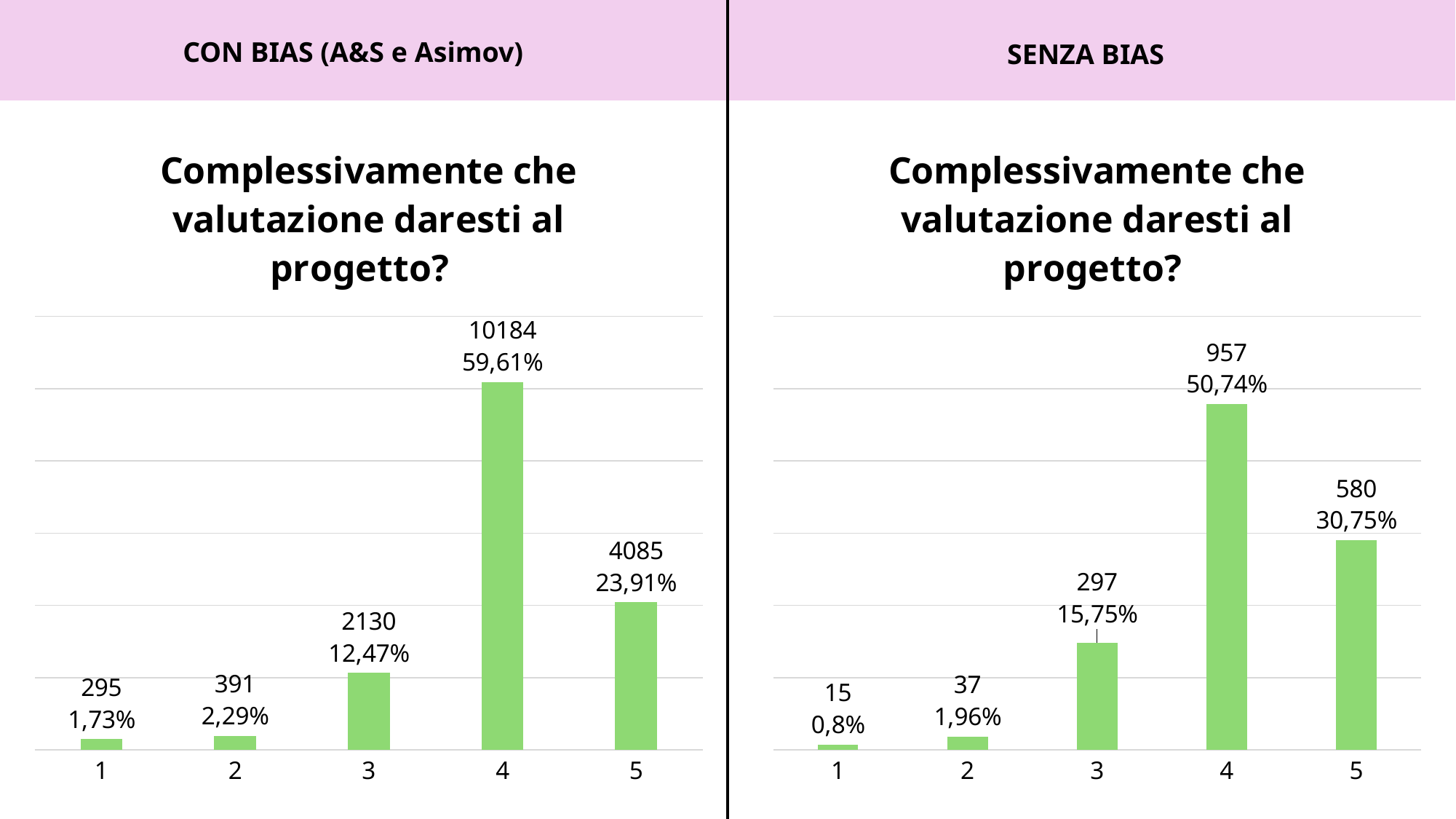
In the left chart (CON BIAS), what is the difference between the counts for rating 4 and rating 5? 6099 What type of chart is used in the SENZA BIAS section? bar chart In the right chart (SENZA BIAS), which is larger: the count for rating 3 or the count for rating 5? rating 5 In the left chart (CON BIAS), what is the count for rating 4? 10184 In the right chart (SENZA BIAS), what is the count for rating 3? 297 In the right chart (SENZA BIAS), what percentage is shown for rating 1? 0,8% In the left chart (CON BIAS), what percentage is shown for rating 5? 23,91% What is the title of the chart in the CON BIAS section? Complessivamente che valutazione daresti al progetto? In the left chart (CON BIAS), which rating has the highest count? 4 In the right chart (SENZA BIAS), which rating has the lowest count? 1 In the right chart (SENZA BIAS), what is the difference between the counts for rating 4 and rating 5? 377 How many rating categories are shown on the x axis of the left chart (CON BIAS)? 5